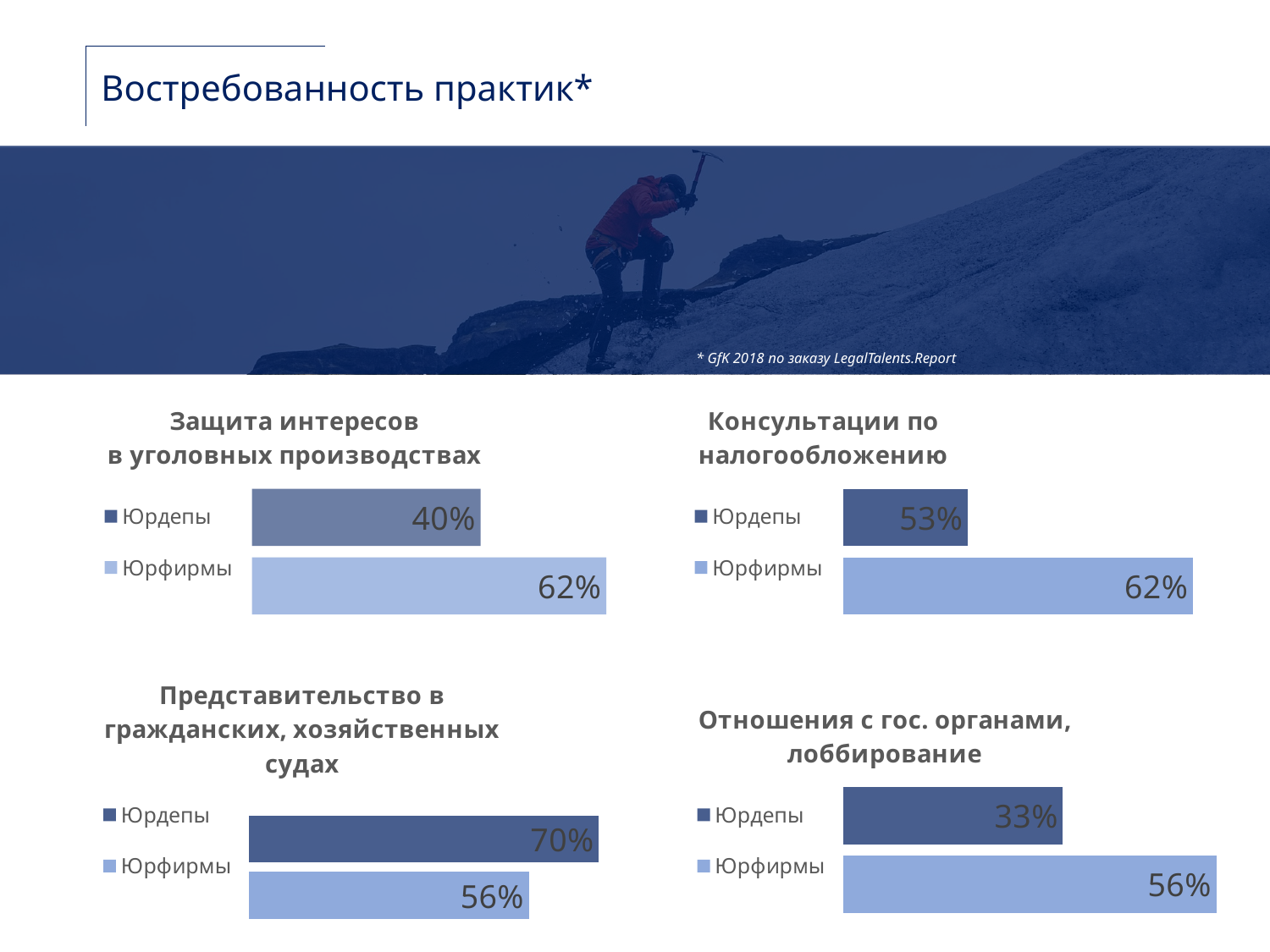
What kind of chart is the chart titled "Представительство в гражданских, хозяйственных судах"? Bar chart In the chart titled "Консультации по налогообложению", what is the value for Юрдепы? 53% In the chart titled "Консультации по налогообложению", what is the difference between the Юрфирмы and Юрдепы values? 9% In the chart titled "Защита интересов в уголовных производствах", what is the value for Юрдепы? 40% In the chart titled "Представительство в гражданских, хозяйственных судах", which is larger, Юрдепы or Юрфирмы? Юрдепы In the chart titled "Отношения с гос. органами, лоббирование", what is the difference between the Юрфирмы and Юрдепы values? 23% In the chart titled "Представительство в гражданских, хозяйственных судах", what is the value for Юрдепы? 70% In the chart titled "Отношения с гос. органами, лоббирование", what is the value for Юрфирмы? 56% In the chart titled "Защита интересов в уголовных производствах", which series has the lowest value? Юрдепы In the chart titled "Защита интересов в уголовных производствах", what is the value for Юрфирмы? 62% In the chart titled "Отношения с гос. органами, лоббирование", what is the value for Юрдепы? 33% How many series does the legend list in the chart titled "Консультации по налогообложению"? 2